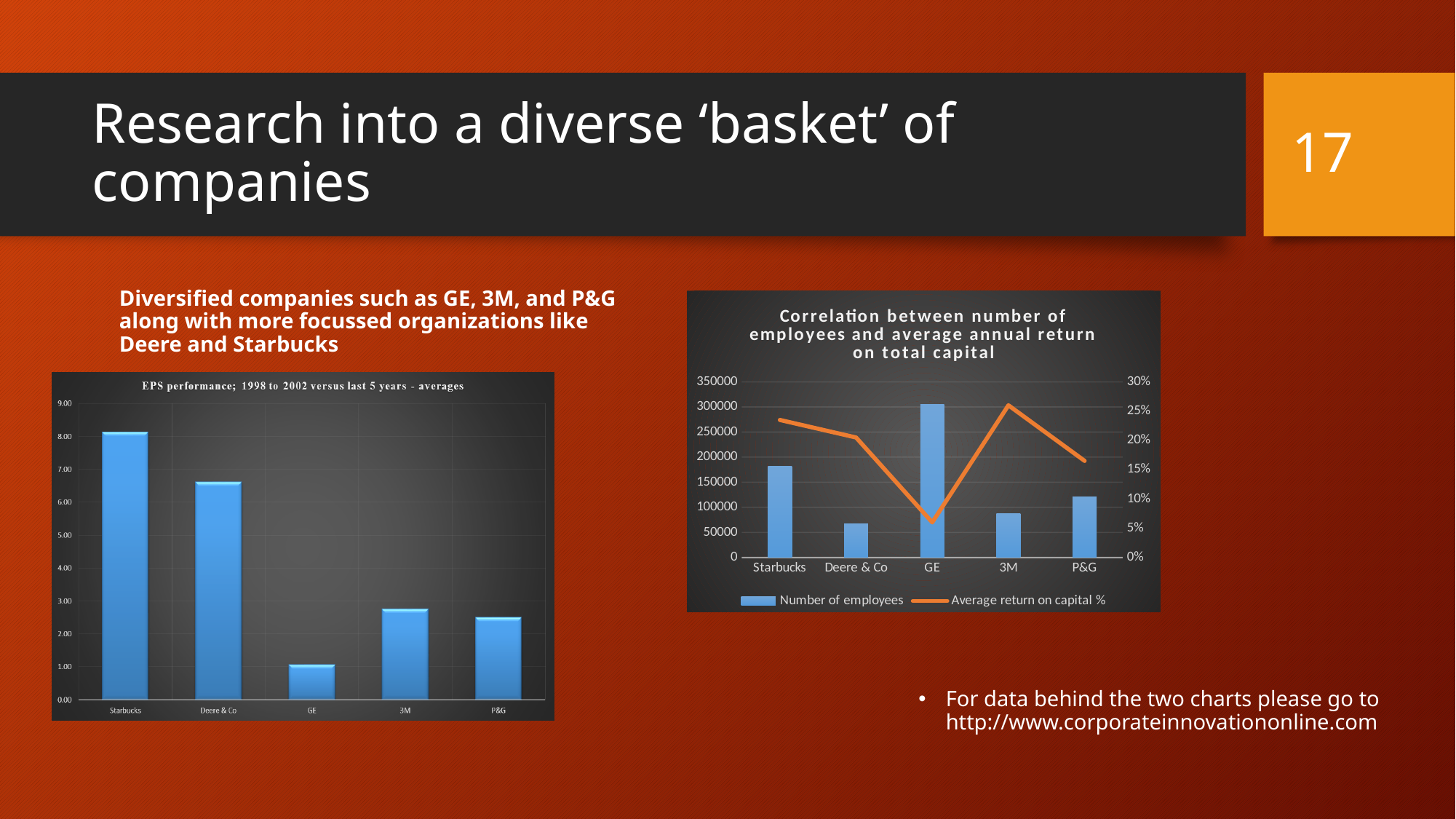
In the 'Correlation between number of employees and average annual return on total capital' chart, which company has the lowest number of employees? Deere & Co In the EPS performance chart on the left, which company has the lowest bar? GE In the EPS performance chart on the left, which is larger, the value for Starbucks or the value for Deere & Co? Starbucks In the EPS performance chart on the left, which company has the highest bar? Starbucks In the EPS performance chart on the left, is the value for Deere & Co greater or less than 6.00? greater How many series does the legend list in the 'Correlation between number of employees and average annual return on total capital' chart? 2 In the EPS performance chart on the left, is the value for 3M greater or less than 3.00? less In the 'Correlation between number of employees and average annual return on total capital' chart, which company has the highest number of employees? GE What kind of chart is the EPS performance chart on the left? bar chart In the 'Correlation between number of employees and average annual return on total capital' chart, which company has the lowest average return on capital %? GE How many companies are shown in the EPS performance chart on the left? 5